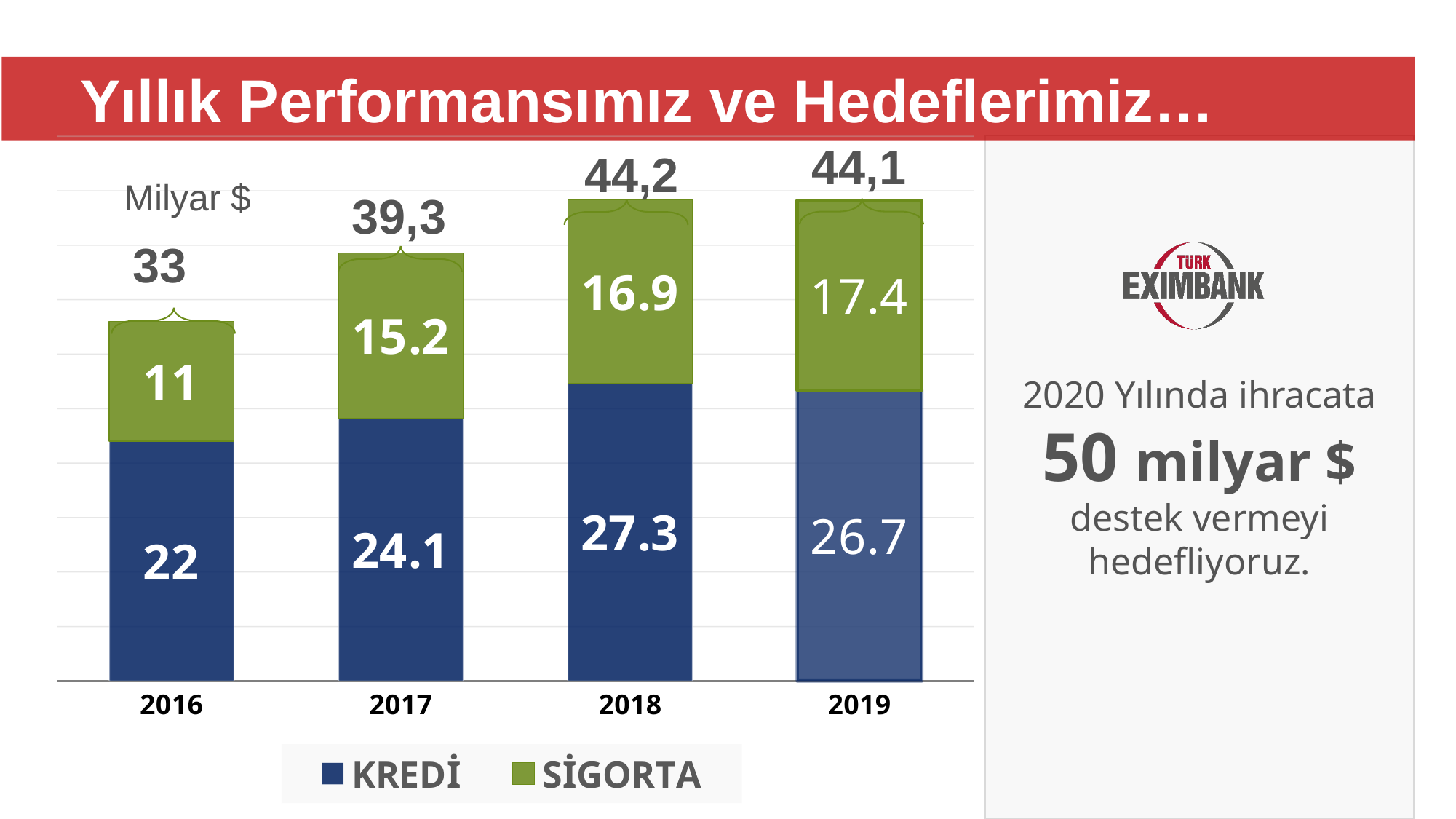
What unit is indicated at the top left of the chart? Milyar $ What is the KREDİ value for 2016? 22 Which is larger, the KREDİ value for 2019 or the KREDİ value for 2017? 2019 What is the total shown above the stacked bar for 2017? 39,3 How many series does the legend list? 2 What is the SİGORTA value for 2019? 17.4 How many years are shown on the x axis? 4 Which year has the lowest SİGORTA value? 2016 What is the difference between the SİGORTA values for 2018 and 2017? 1.7 What is the KREDİ value for 2018? 27.3 What kind of chart is shown on the slide? Stacked bar chart Which year has the highest KREDİ value? 2018